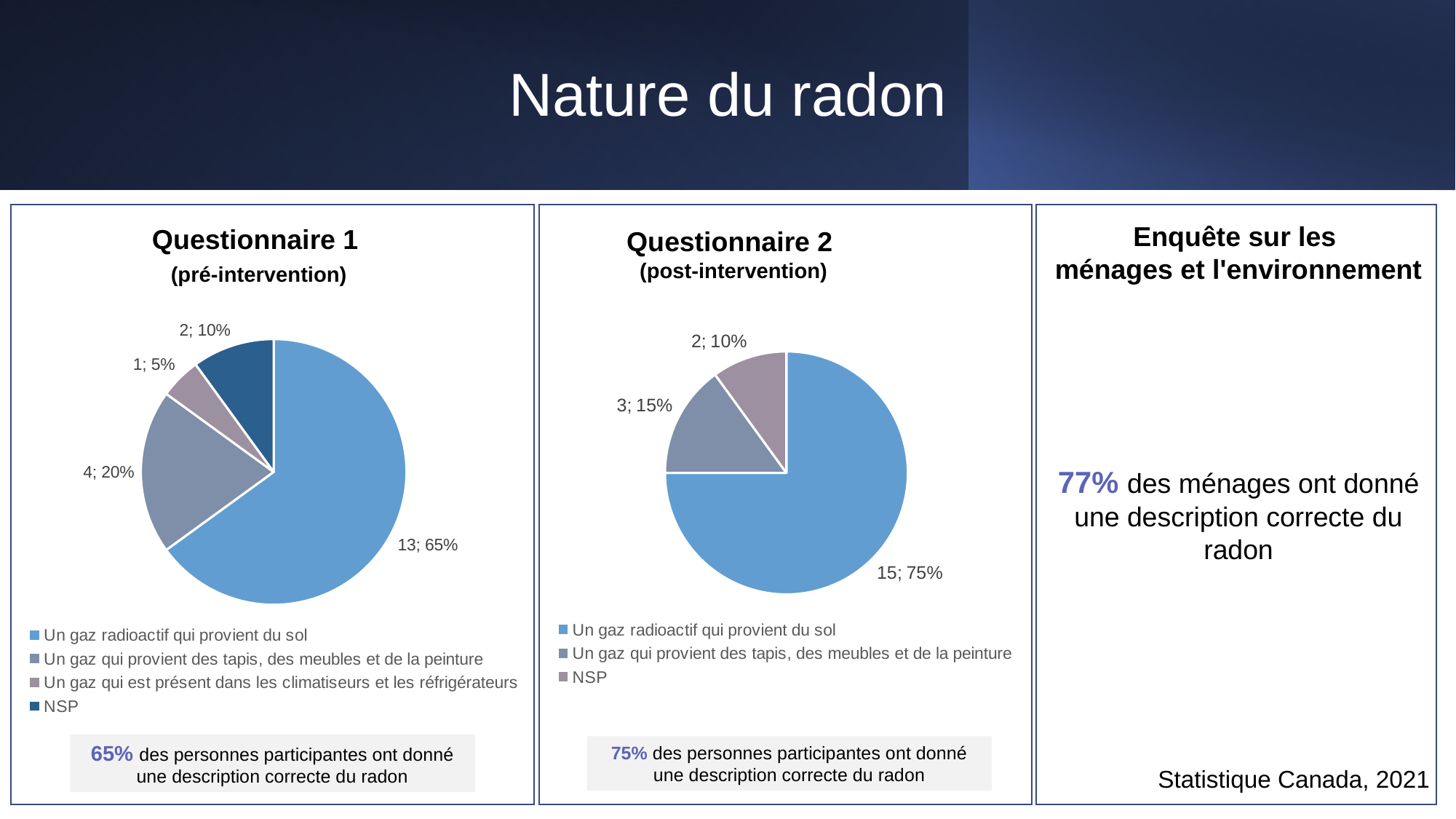
In the Questionnaire 1 (pré-intervention) pie chart, what share of responses is 'Un gaz radioactif qui provient du sol'? 65% How many categories does the legend of the Questionnaire 1 (pré-intervention) pie chart list? 4 In the Questionnaire 2 (post-intervention) pie chart, how many respondents answered 'NSP'? 2 In the Questionnaire 2 (post-intervention) pie chart, what share of responses is 'Un gaz radioactif qui provient du sol'? 75% In the Questionnaire 1 (pré-intervention) pie chart, which category has the smallest slice? Un gaz qui est présent dans les climatiseurs et les réfrigérateurs In the Questionnaire 1 (pré-intervention) pie chart, how many respondents answered 'Un gaz qui provient des tapis, des meubles et de la peinture'? 4 Which is larger: the count for 'Un gaz qui provient des tapis, des meubles et de la peinture' in the Questionnaire 1 pie chart or in the Questionnaire 2 pie chart? Questionnaire 1 In the Questionnaire 2 (post-intervention) pie chart, what is the difference in percentage points between 'Un gaz radioactif qui provient du sol' and 'Un gaz qui provient des tapis, des meubles et de la peinture'? 60% What kind of chart is used in the Questionnaire 1 (pré-intervention) panel? pie chart In the Questionnaire 1 (pré-intervention) pie chart, what is the difference in count between 'Un gaz radioactif qui provient du sol' and 'NSP'? 11 How many categories does the legend of the Questionnaire 2 (post-intervention) pie chart list? 3 In the Questionnaire 2 (post-intervention) pie chart, which category has the largest slice? Un gaz radioactif qui provient du sol